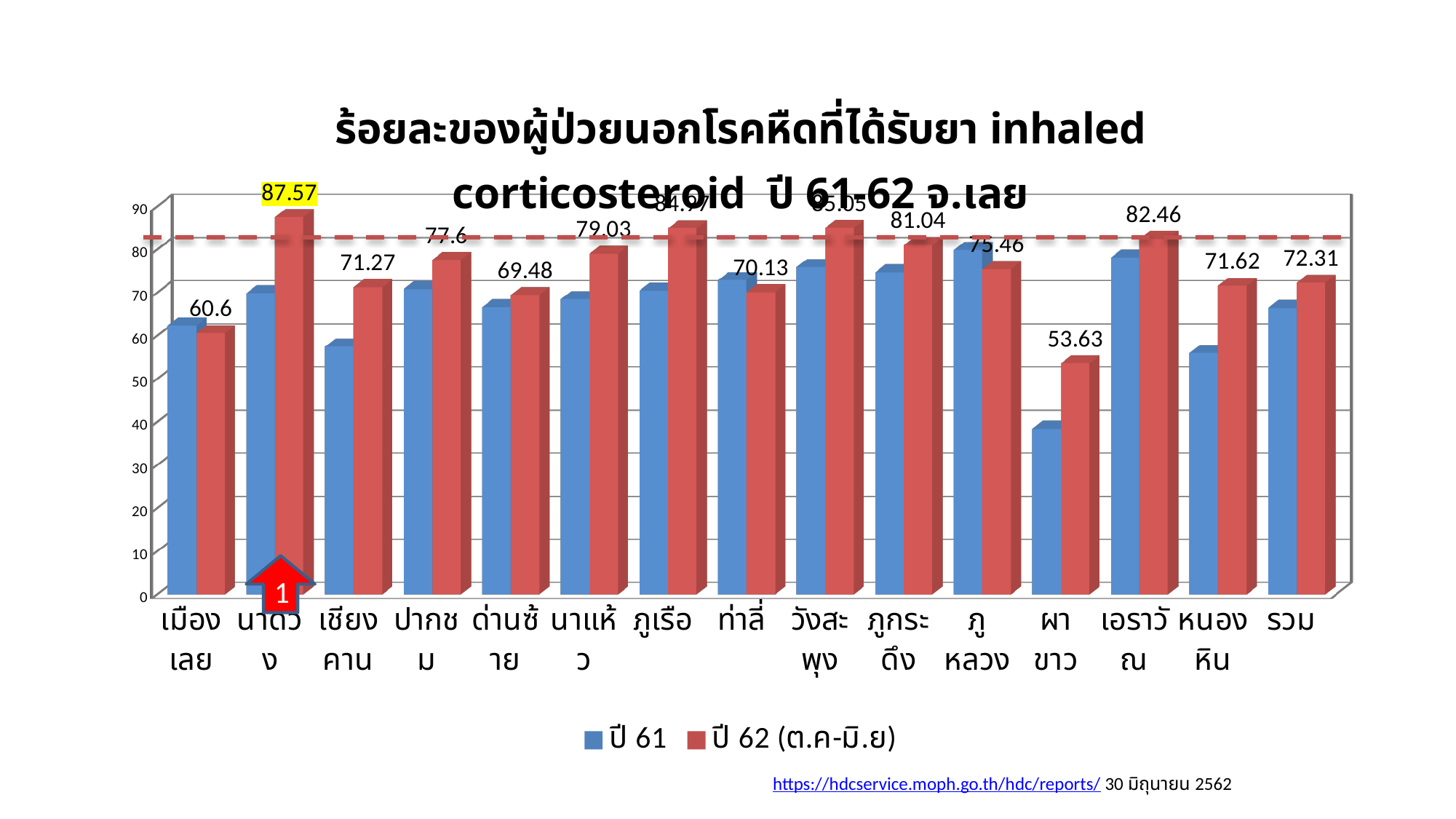
How many series does the legend list? 2 Which category has the highest ปี 62 (ต.ค-มิ.ย) value? นาด้วง What is the ปี 62 (ต.ค-มิ.ย) value for รวม? 72.31 What is the ปี 62 (ต.ค-มิ.ย) value for นาด้วง? 87.57 Is the ปี 61 value for ผาขาว greater or less than 50? less What is the ปี 62 (ต.ค-มิ.ย) value for ผาขาว? 53.63 What kind of chart is shown on the slide? bar chart Is the ปี 61 value for เอราวัณ greater or less than 70? greater Which category has the lowest ปี 62 (ต.ค-มิ.ย) value? ผาขาว How many categories are shown on the x axis? 15 Which has the larger ปี 62 (ต.ค-มิ.ย) value, เชียงคาน or ปากชม? ปากชม What is the difference between the ปี 62 (ต.ค-มิ.ย) values for นาด้วง and ผาขาว? 33.94